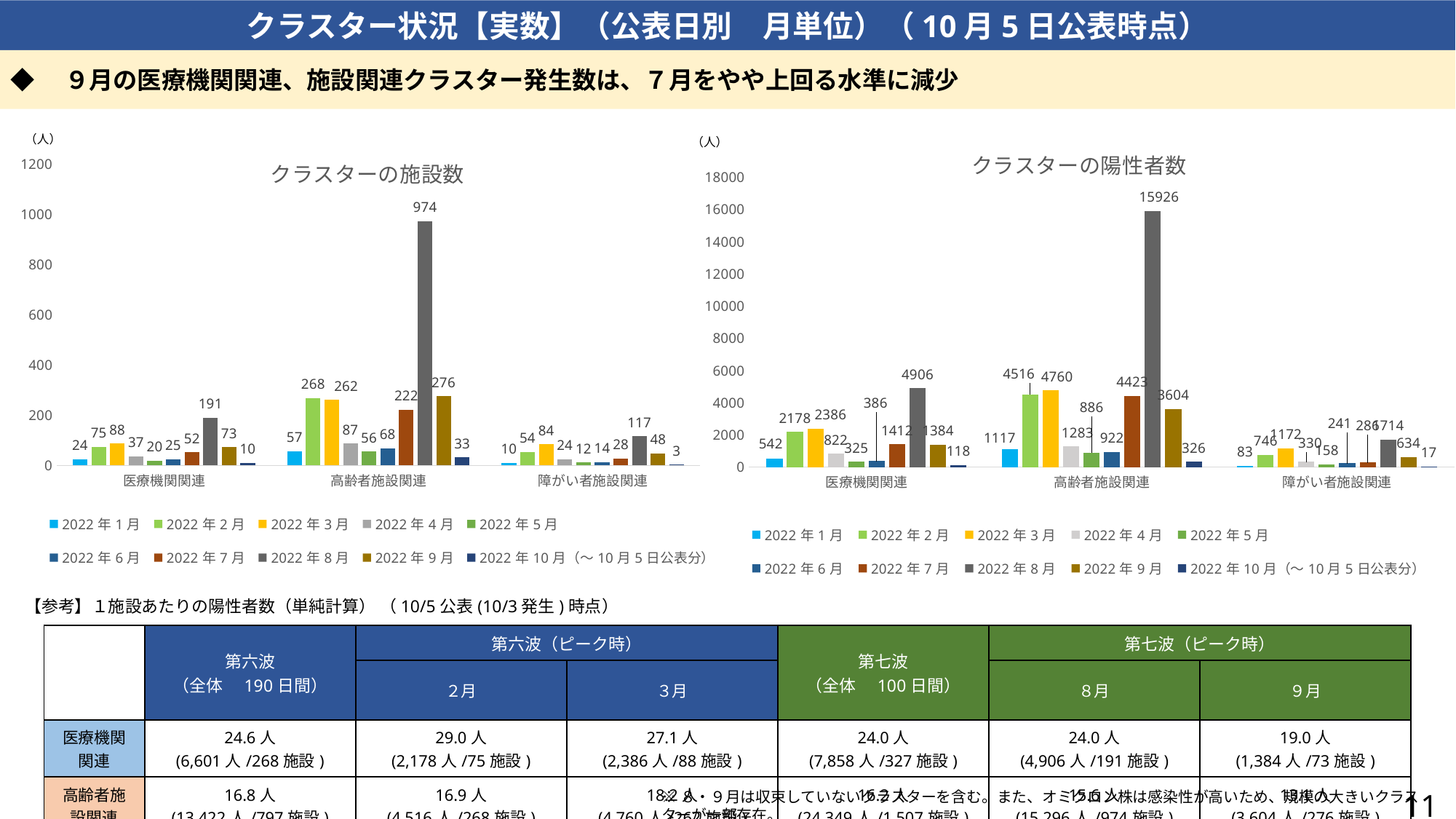
In the chart titled クラスターの施設数, what is the difference between the 2022年9月 and 2022年7月 values for 高齢者施設関連? 54 In the chart titled クラスターの陽性者数, what is the difference between the 2022年8月 and 2022年9月 values for 医療機関関連? 3522 In the chart titled クラスターの陽性者数, which is larger for 高齢者施設関連: 2022年2月 or 2022年3月? 2022年3月 How many categories are shown on the x axis of the chart titled クラスターの陽性者数? 3 In the chart titled クラスターの陽性者数, which month has the lowest value for 障がい者施設関連? 2022年10月（～10月5日公表分） What kind of chart is the chart titled クラスターの施設数? Bar chart In the chart titled クラスターの施設数, how many series does the legend list? 10 In the chart titled クラスターの施設数, which month has the highest value for 障がい者施設関連? 2022年8月 In the chart titled クラスターの陽性者数, what is the value for 高齢者施設関連 in 2022年8月? 15926 In the chart titled クラスターの施設数, what is the value for 高齢者施設関連 in 2022年8月? 974 In the chart titled クラスターの陽性者数, what is the value for 医療機関関連 in 2022年3月? 2386 In the chart titled クラスターの施設数, what is the value for 医療機関関連 in 2022年9月? 73